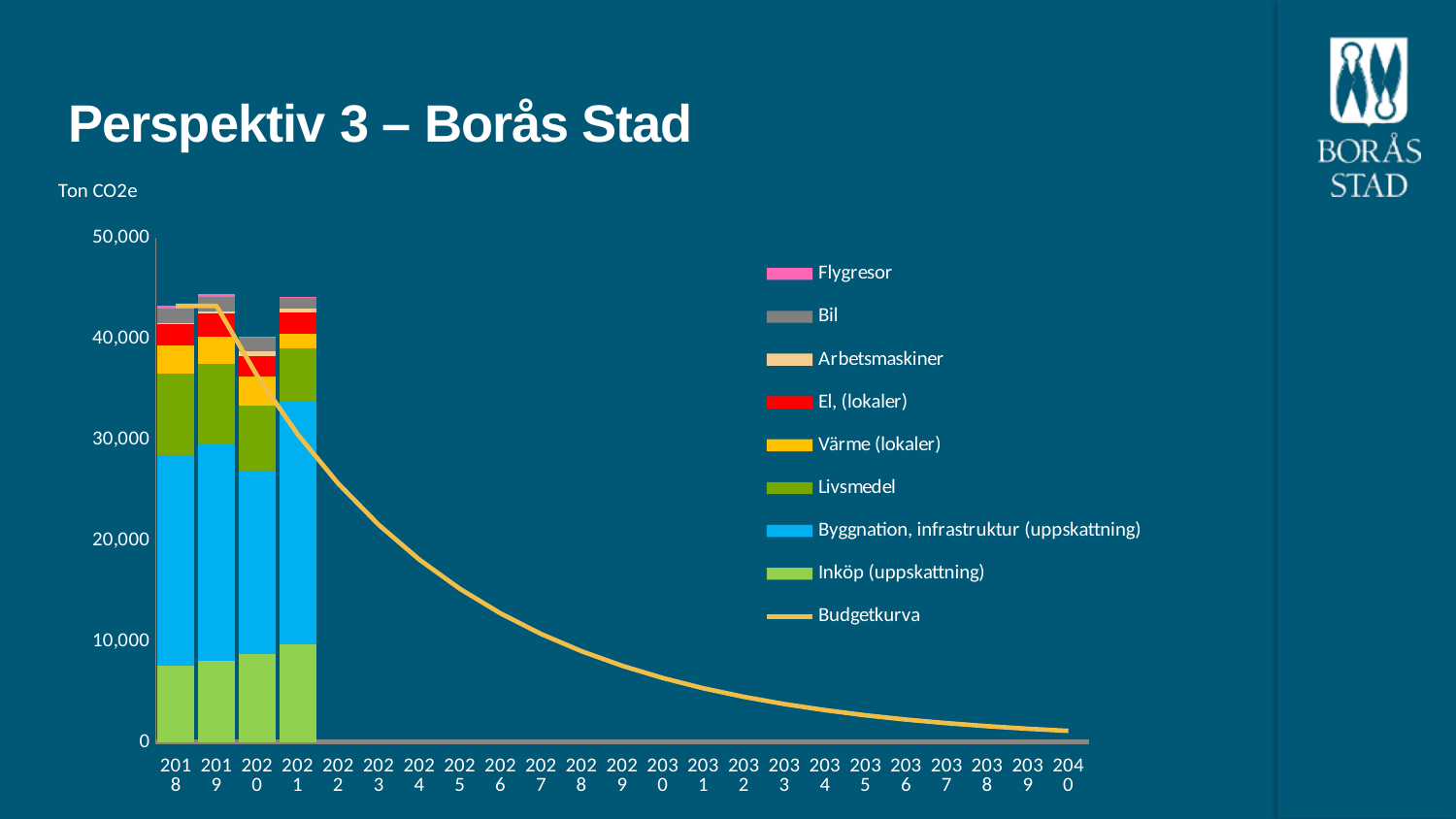
How many entries does the legend list? 9 For how many years are stacked bars plotted? 4 Is the total of the stacked bar for 2019 greater or less than 50,000? less What unit is shown above the y axis? Ton CO2e Which legend entry is drawn as a line rather than a bar segment? Budgetkurva What kind of chart is shown on the slide? Stacked bar chart with a line Is the Budgetkurva value for 2030 greater or less than 10,000? less Is the total of the stacked bar for 2018 greater or less than 40,000? greater How many years are labelled along the x axis? 23 Which year has the lowest stacked bar total? 2020 Does the Budgetkurva line rise or fall from 2019 to 2040? fall